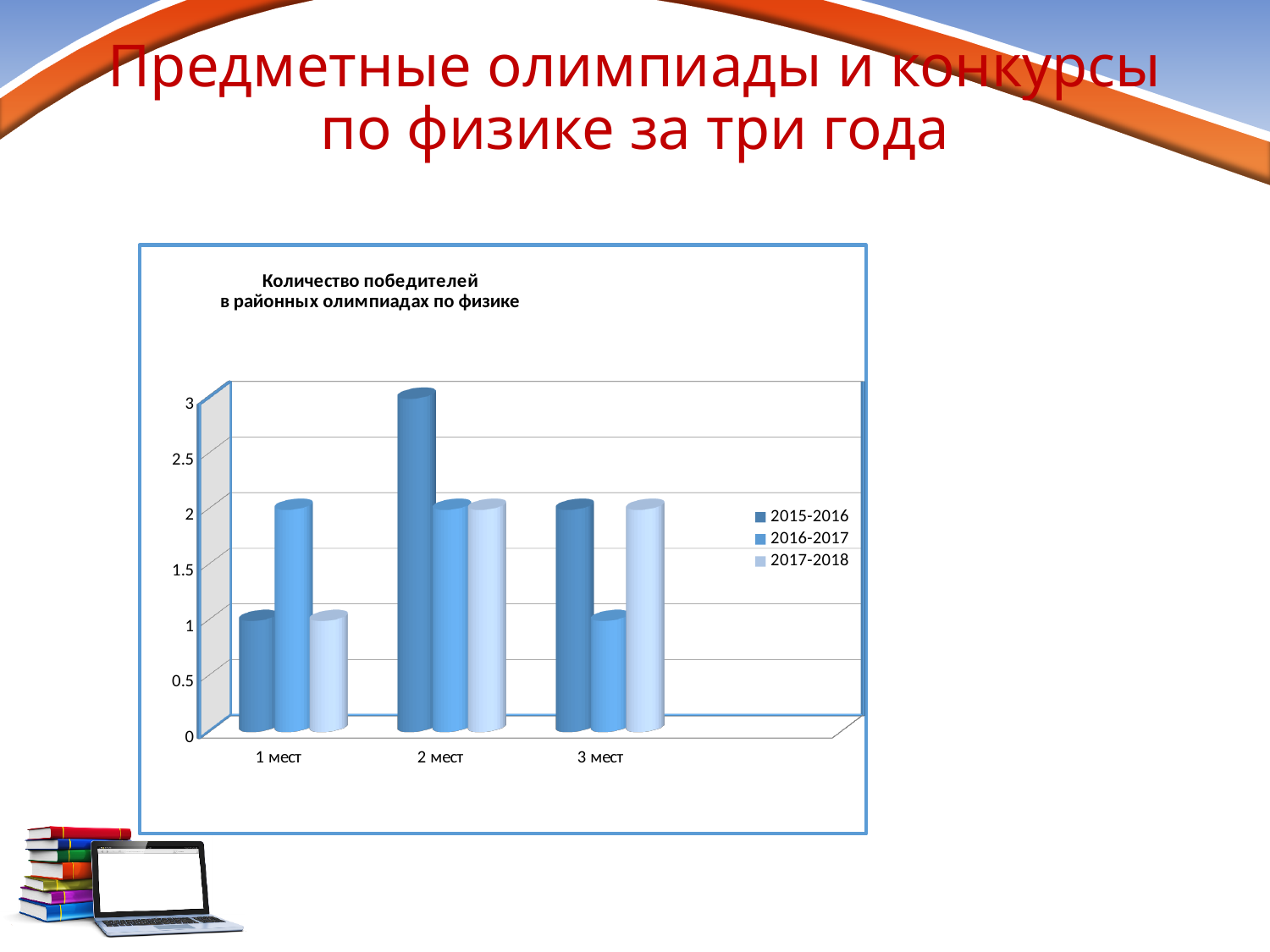
In the category 1 мест, which is larger: the value for 2016-2017 or the value for 2017-2018? 2016-2017 Which category has the highest value for the 2015-2016 series? 2 мест How many categories are shown on the x axis? 3 What kind of chart is shown on the slide? bar chart Which category has the lowest value for the 2016-2017 series? 3 мест What is the value for 2016-2017 in the category 1 мест? 2 How many series does the legend list? 3 What is the value for 2017-2018 in the category 3 мест? 2 What is the difference between the 2015-2016 and 2016-2017 values in the category 2 мест? 1 What is the value for 2015-2016 in the category 2 мест? 3 Is the value for 2015-2016 in the category 2 мест greater or less than 2.5? greater What is the title of the chart? Количество победителей в районных олимпиадах по физике